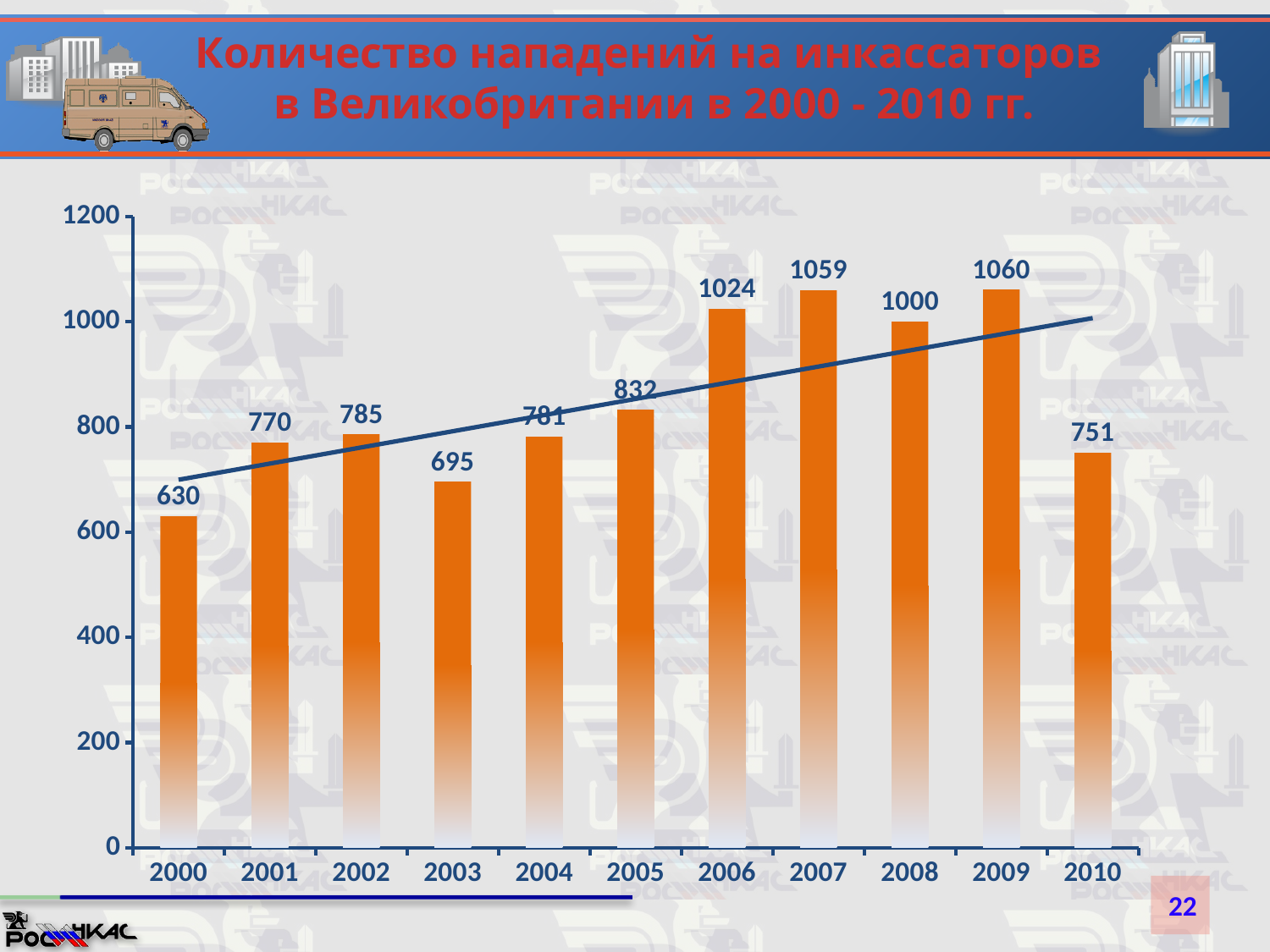
Which is larger, the value for 2001 or the value for 2004? 2004 Do the values generally rise or fall from 2000 to 2009? rise How many years are shown on the x axis? 11 What is the value for 2010? 751 Is the value for 2008 greater or less than 800? greater Which year has the lowest value? 2000 Which year has the highest value? 2009 What is the value for 2006? 1024 What is the difference between the values for 2006 and 2005? 192 What is the difference between the values for 2009 and 2010? 309 What kind of chart is shown on the slide? bar chart What is the value for 2003? 695